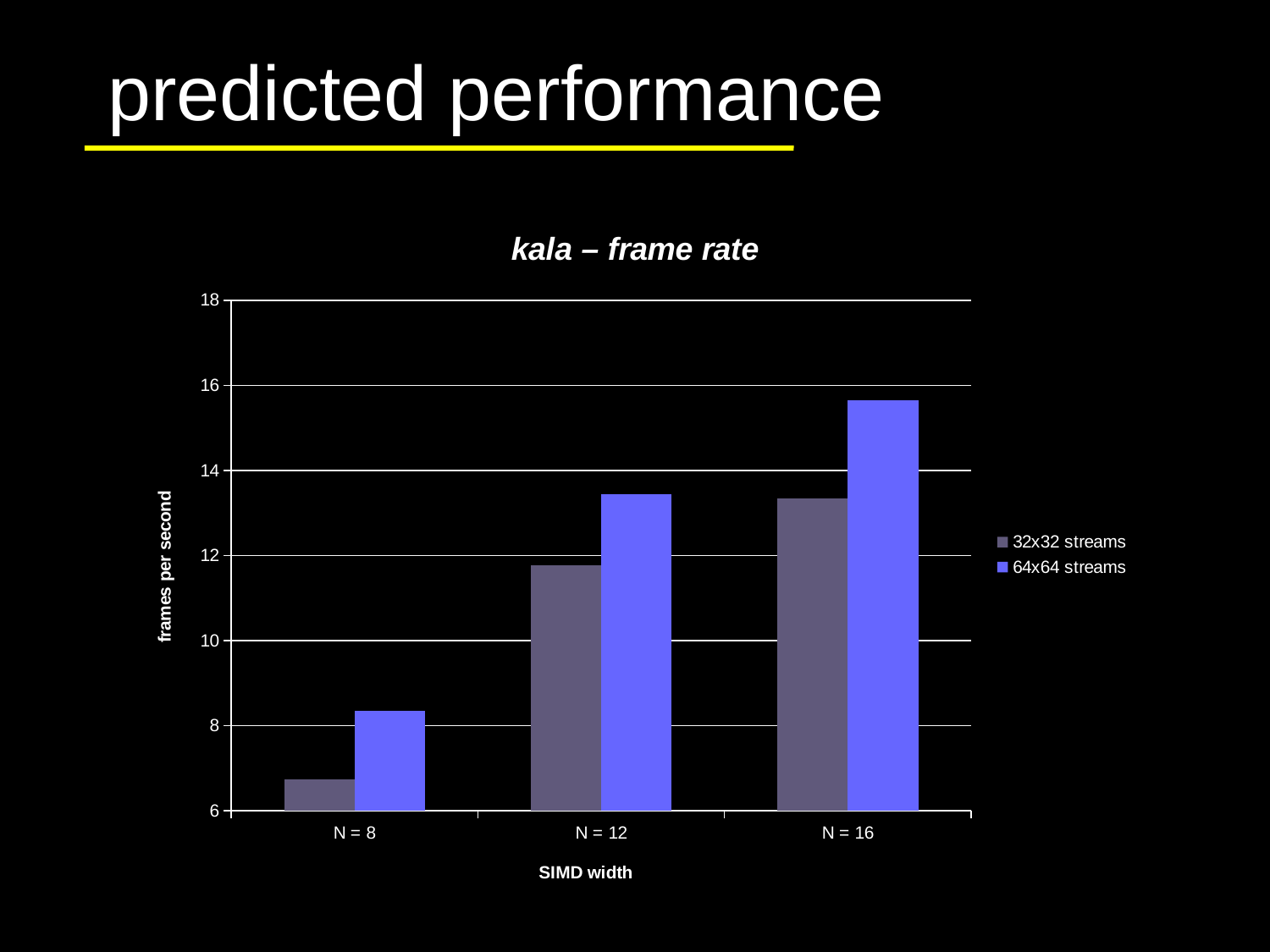
Do the frame rates for 64x64 streams rise or fall as SIMD width increases from N = 8 to N = 16? rise Is the value for 32x32 streams at N = 8 greater or less than 8? less At N = 12, which series has the higher frame rate, 32x32 streams or 64x64 streams? 64x64 streams Which SIMD width has the lowest frame rate for 32x32 streams? N = 8 What is the label of the y axis? frames per second What is the title of the chart? kala – frame rate How many SIMD width categories are shown on the x axis? 3 How many series does the legend list? 2 Is the value for 64x64 streams at N = 16 greater or less than 14? greater What kind of chart is shown on the slide? bar chart Is the value for 32x32 streams at N = 12 greater or less than 10? greater Which SIMD width has the highest frame rate for 64x64 streams? N = 16